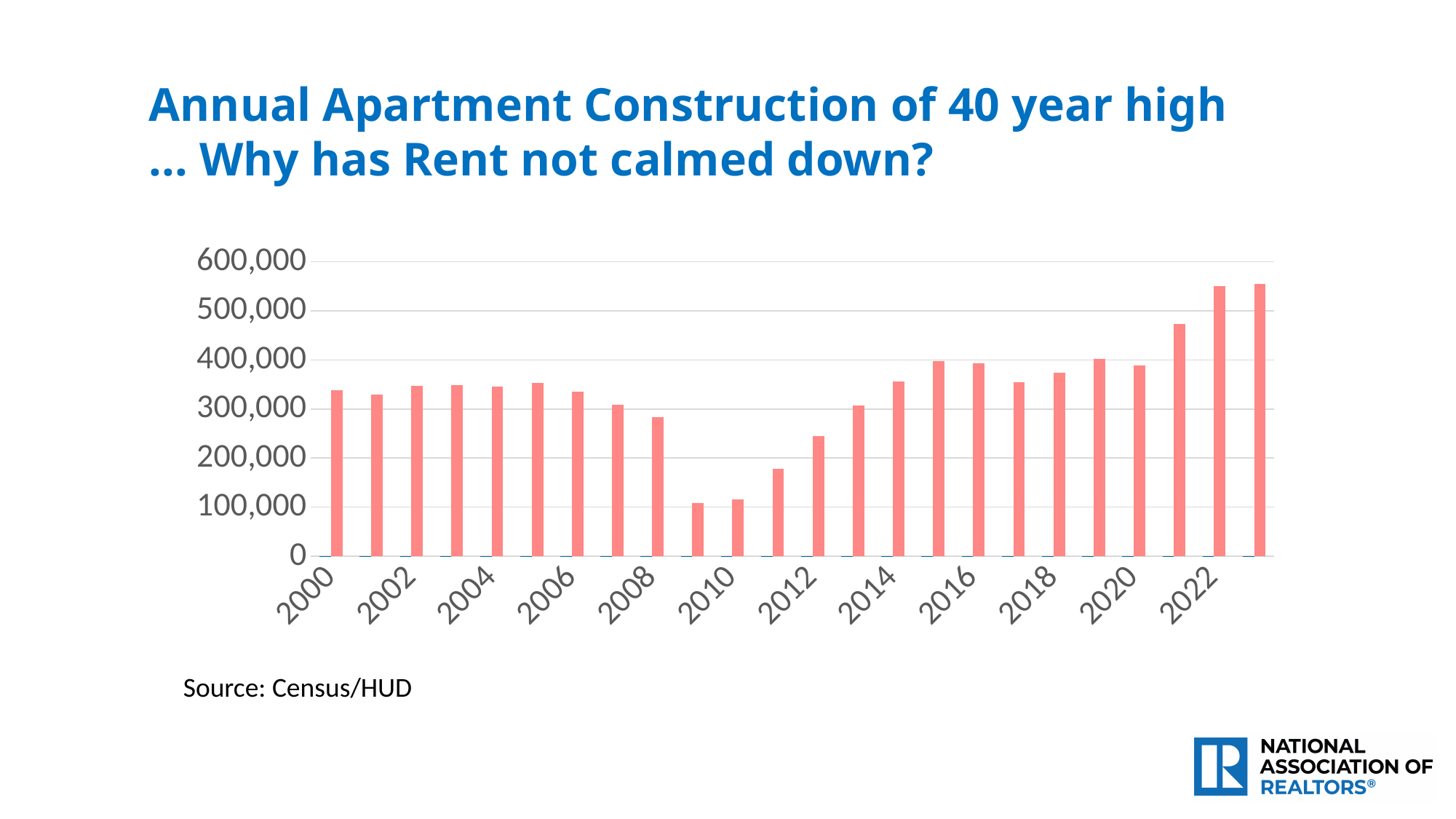
What kind of chart is shown on the slide? bar chart Is the value for 2022 greater or less than 500,000? greater Which year has the larger value, 2006 or 2008? 2006 Do the values rise or fall from 2006 to 2010? fall What source is cited for the chart data? Census/HUD Is the value for 2014 greater or less than 300,000? greater How many bars (years) are plotted in the chart? 24 Is the value for 2010 greater or less than 200,000? less Do the values rise or fall from 2010 to 2022? rise Which year has the larger value, 2022 or 2010? 2022